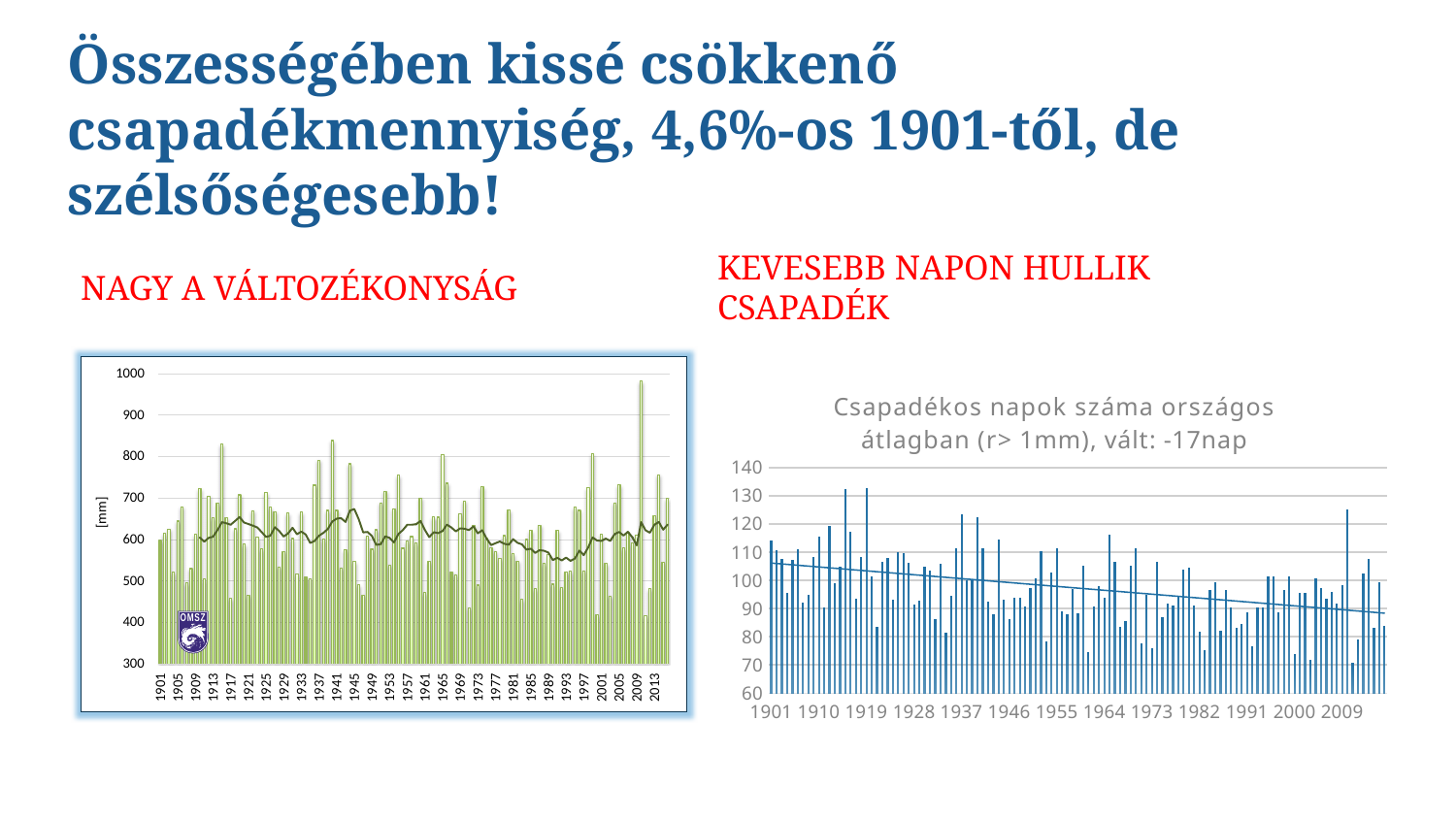
What unit is shown on the y axis of the chart on the left of the slide? mm In the chart on the right, is the value for 1901 greater or less than 100? greater What kind of chart is the chart on the left of the slide? bar chart In the chart on the left, what is the last year labelled on the x axis? 2013 In the chart on the right, what is the lowest value shown on the y axis? 60 In the chart on the right, does the trend line rise or fall from 1901 to 2009? fall What kind of chart is the chart on the right of the slide? bar chart In the chart on the left, is the value for 1901 greater or less than 500? greater In the chart on the left, is the tallest bar greater or less than 900? greater In the chart on the right, what is the last year labelled on the x axis? 2009 What is the title of the chart on the right of the slide? Csapadékos napok száma országos átlagban (r> 1mm), vált: -17nap In the chart on the right, what is the first year labelled on the x axis? 1901